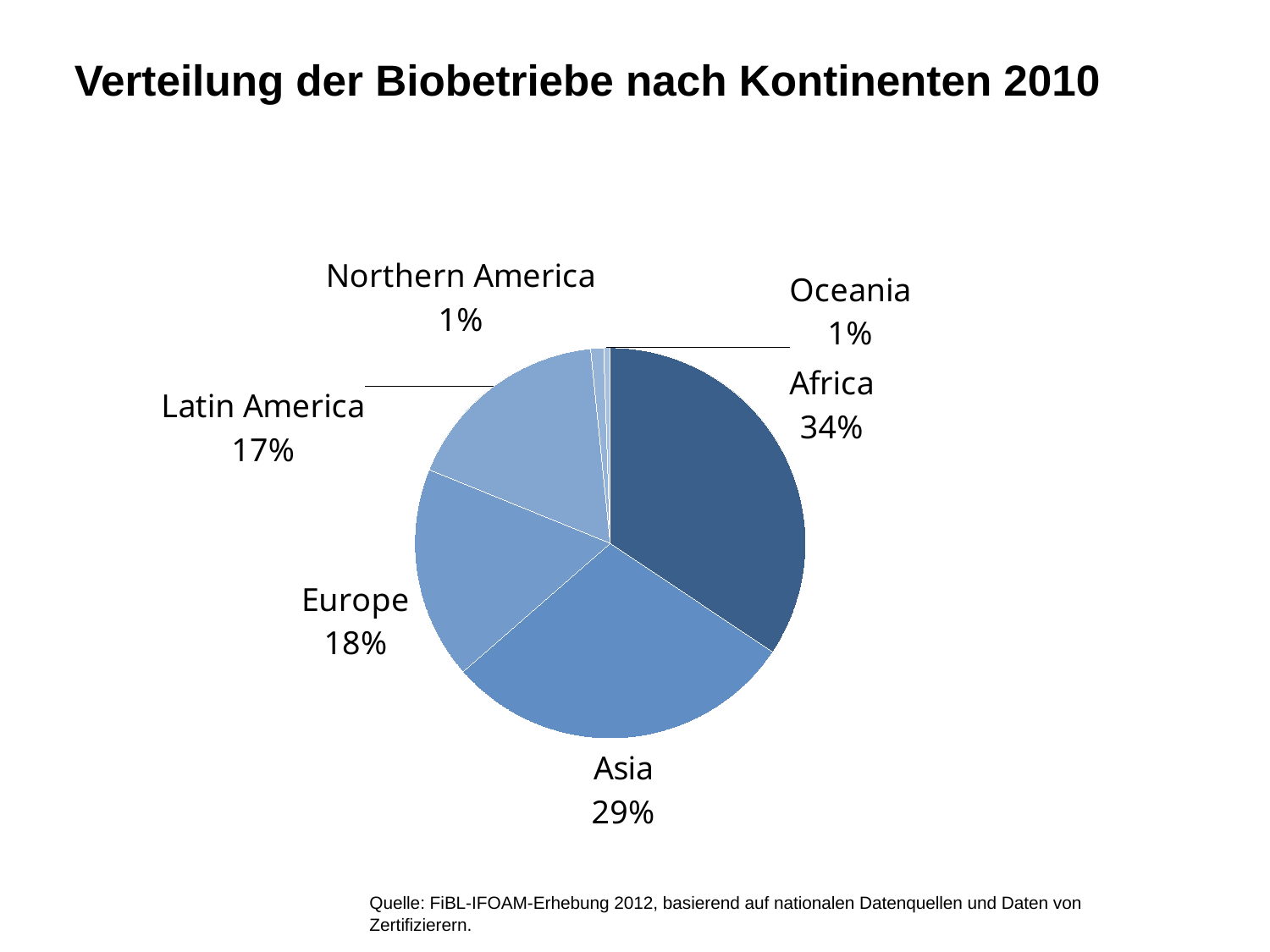
Which continent has the largest slice of the pie? Africa What is the title of the slide? Verteilung der Biobetriebe nach Kontinenten 2010 What is the difference in percentage points between Europe and Latin America? 1 What is the value shown for Asia? 29% How many slices does the pie chart have? 6 What share of the pie does Africa hold? 34% Which is larger, the share for Europe or the share for Asia? Asia What kind of chart is shown on the slide? Pie chart What is the value shown for Europe? 18% What is the value shown for Latin America? 17% What share of the pie does Oceania hold? 1% What is the difference in percentage points between Africa and Asia? 5